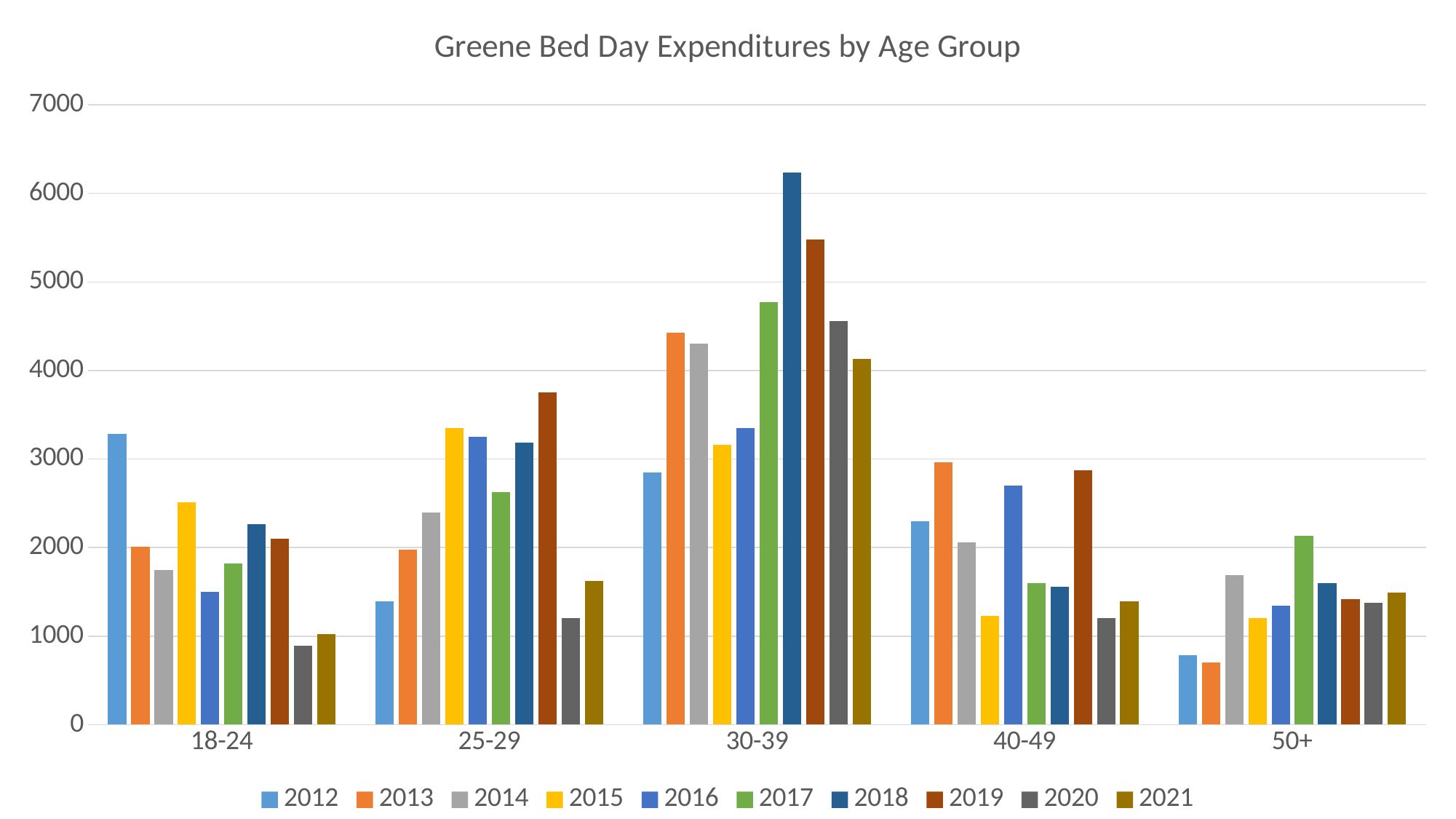
Which year has the highest value in the 50+ age group? 2017 What is the title of the chart? Greene Bed Day Expenditures by Age Group Is the value for 2018 in the 30-39 age group greater or less than 6000? greater How many age groups are shown on the x axis? 5 What kind of chart is shown on the slide? bar chart Is the value for 2012 in the 50+ age group greater or less than 1000? less Which age group has the highest value for 2018? 30-39 In the 18-24 age group, which is larger: the value for 2012 or the value for 2013? 2012 In the 40-49 age group, which is larger: the value for 2013 or the value for 2014? 2013 How many series does the legend list? 10 Is the value for 2019 in the 25-29 age group greater or less than 3500? greater